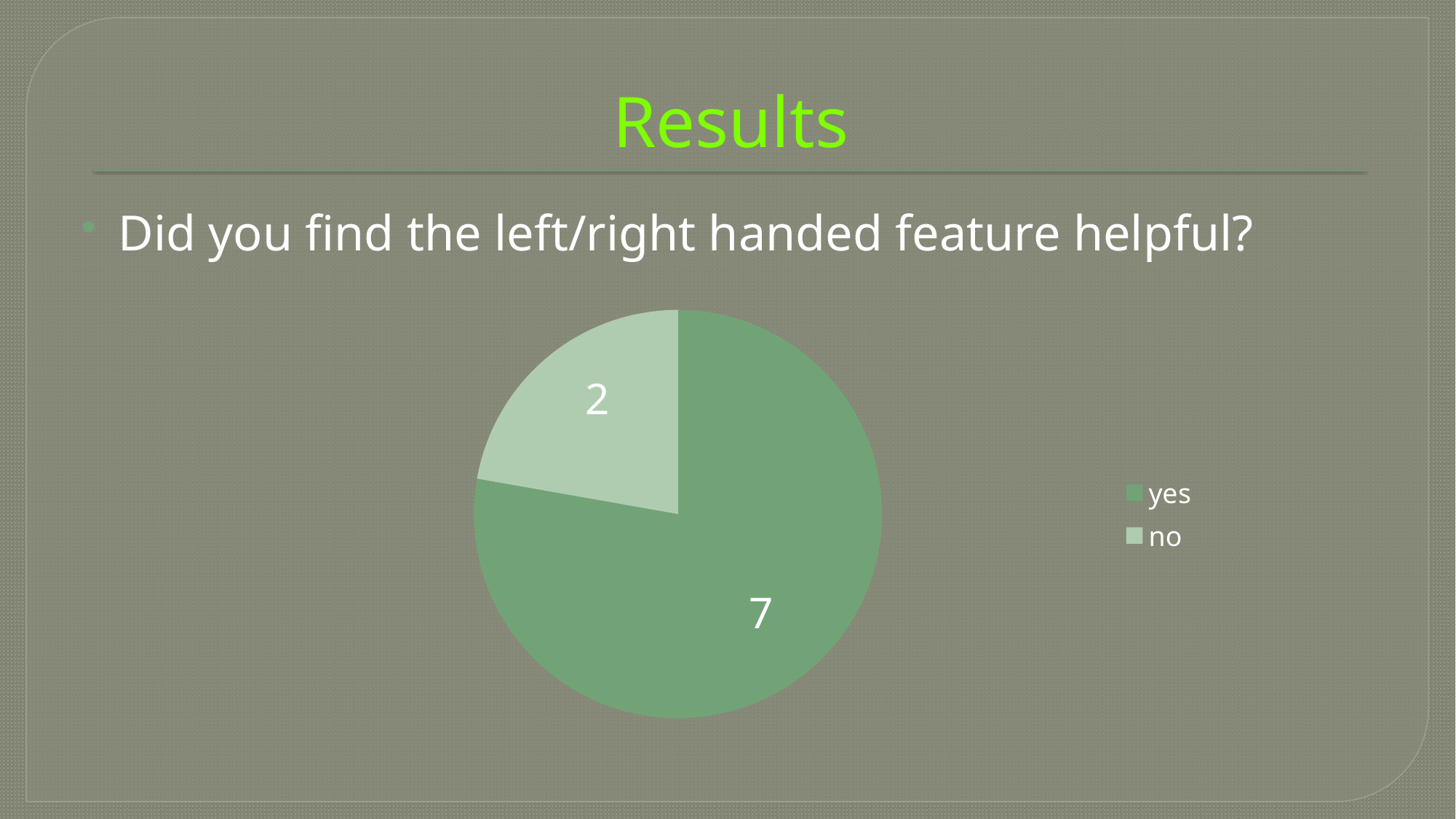
How many slices does the pie chart have? 2 Which response has the largest slice of the pie? yes What question do the pie chart results answer? Did you find the left/right handed feature helpful? What type of chart is shown on the slide? pie chart How many entries does the legend list? 2 How many respondents answered "yes"? 7 How many respondents answered "no"? 2 Which response has the smallest slice of the pie? no What is the difference between the number of "yes" and "no" responses? 5 What is the total number of responses shown in the pie chart? 9 Which is larger, the "yes" slice or the "no" slice? yes Which legend entry is shown in the lighter green colour? no